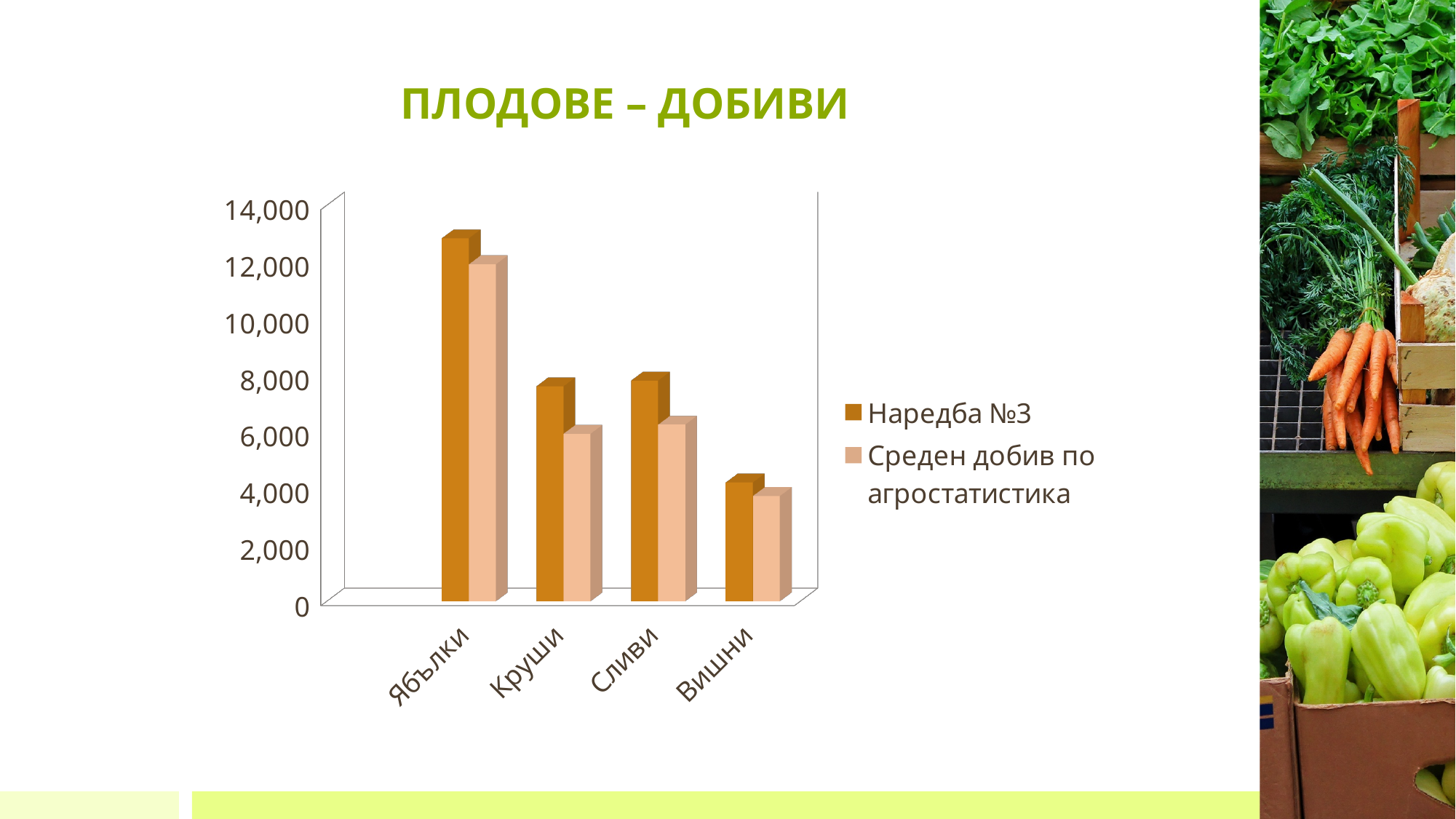
What are the two series named in the chart legend? Наредба №3 and Среден добив по агростатистика Which category has the highest value for the Наредба №3 series? Ябълки For Ябълки, which series has the larger value: Наредба №3 or Среден добив по агростатистика? Наредба №3 How many fruit categories are shown on the x axis of the chart? 4 What is the title of the slide containing the chart? ПЛОДОВЕ – ДОБИВИ Is the Среден добив по агростатистика value for Ябълки greater or less than 10,000? greater Is the Наредба №3 value for Круши greater or less than 8,000? less How many series does the chart legend list? 2 Which category has the lowest value for the Среден добив по агростатистика series? Вишни Is the Наредба №3 value for Вишни greater or less than 6,000? less What kind of chart is shown on the slide? Bar chart